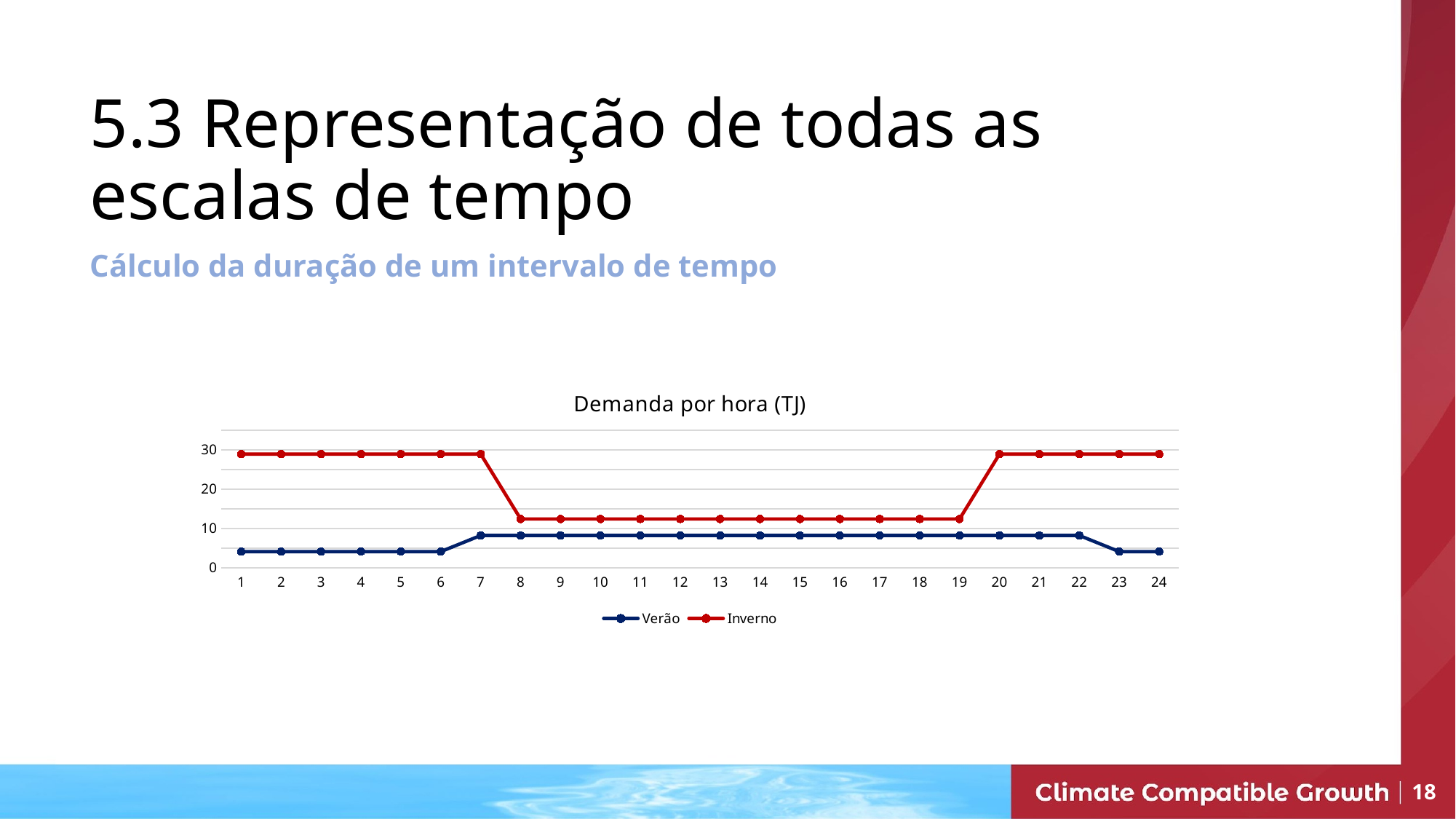
Is the value for Inverno at hour 22 greater or less than 20? greater How many series does the legend list? 2 What kind of chart is shown on the slide? line chart Which series is drawn in red? Inverno Is the value for Inverno at hour 12 greater or less than 20? less Is the value for Inverno at hour 3 greater or less than 20? greater What is the title of the chart? Demanda por hora (TJ) Does the Verão series rise or fall between hour 6 and hour 7? rise At hour 5, which series has the higher value, Verão or Inverno? Inverno Does the Inverno series rise or fall between hour 7 and hour 8? fall How many hours (points) are plotted along the x axis for each series? 24